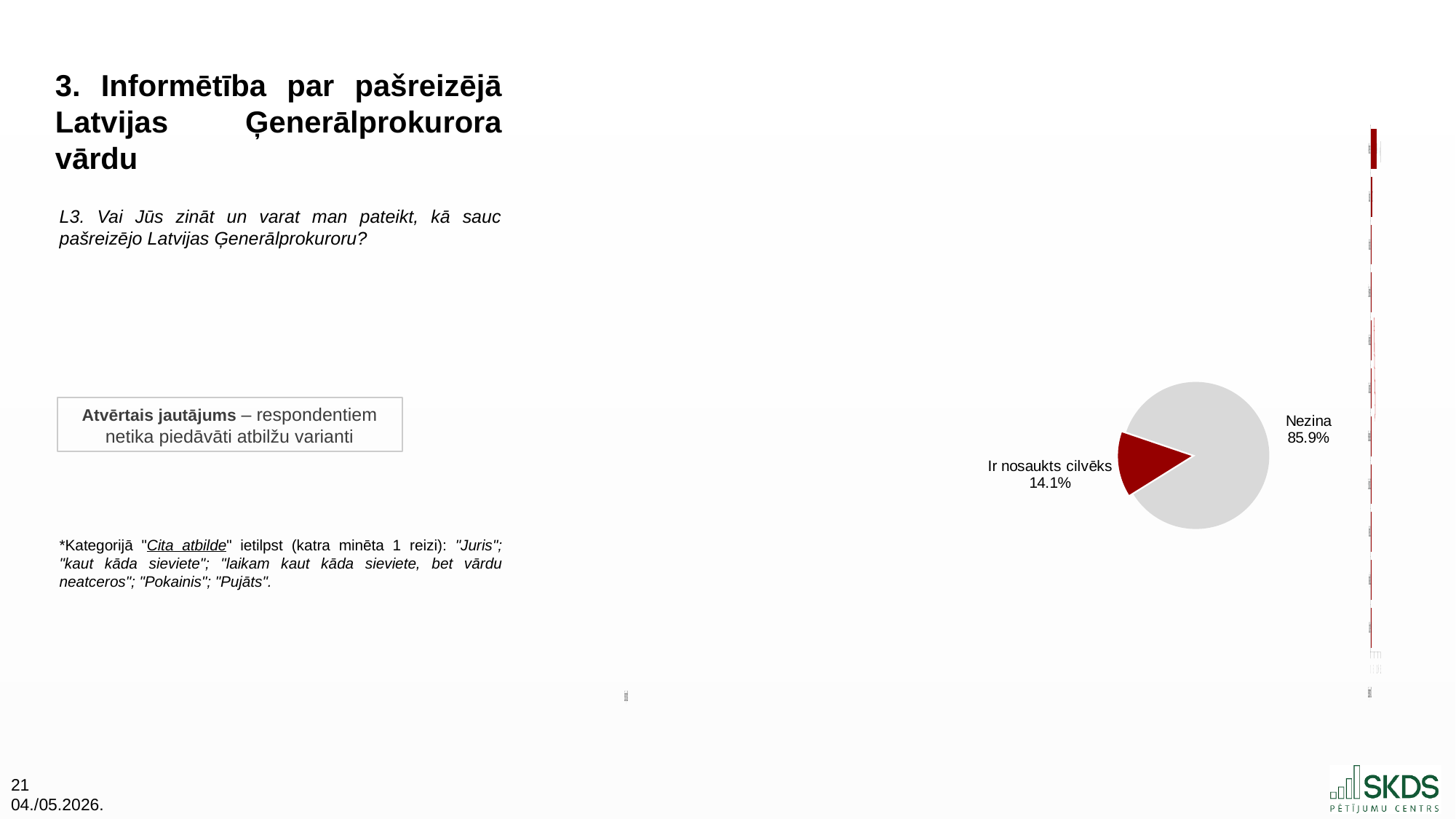
Which is larger in the pie chart, "Nezina" or "Ir nosaukts cilvēks"? Nezina What is the value for "Nezina" in the pie chart? 85.9% Which slice of the pie chart is the smallest? Ir nosaukts cilvēks What share of the pie does the "Ir nosaukts cilvēks" slice represent? 14.1% What colour is the "Ir nosaukts cilvēks" slice in the pie chart? dark red What colour is the "Nezina" slice in the pie chart? light grey Which slice of the pie chart is the largest? Nezina What kind of chart is shown on the slide? pie chart What is the value for "Ir nosaukts cilvēks" in the pie chart? 14.1% How many slices does the pie chart have? 2 What is the difference between the "Nezina" and "Ir nosaukts cilvēks" values in the pie chart? 71.8%